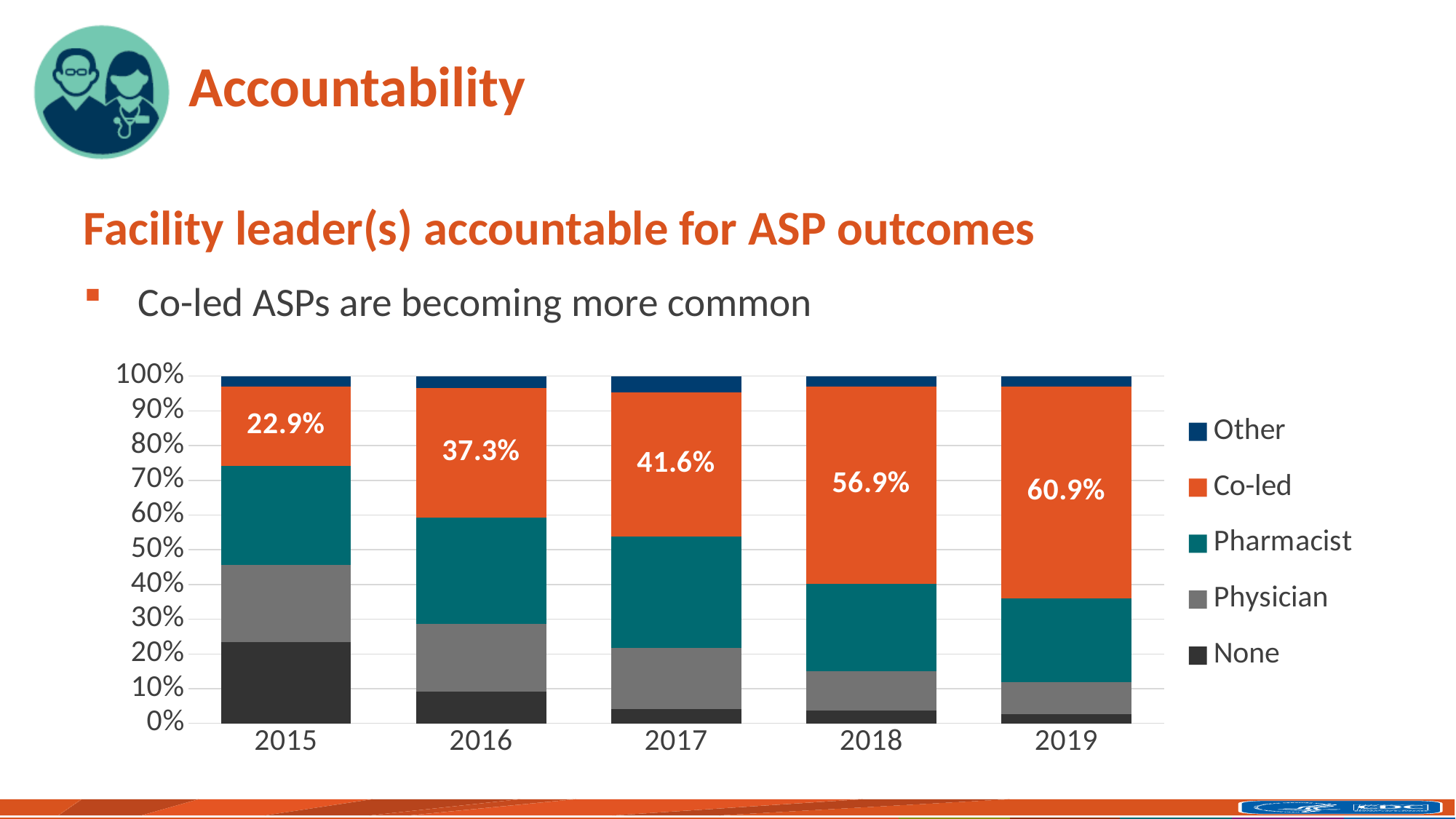
How many years are shown on the x axis? 5 How many series does the legend list? 5 Which year has a larger Co-led share, 2016 or 2018? 2018 In which year is the Co-led share lowest? 2015 What kind of chart is shown on the slide? Stacked bar chart What is the Co-led percentage for 2015? 22.9% In which year is the Co-led share highest? 2019 What is the Co-led percentage for 2017? 41.6% Is the value for None in 2015 greater or less than 20%? greater By how many percentage points did the Co-led share increase from 2015 to 2019? 38.0 percentage points Is the value for None in 2019 greater or less than 10%? less What is the Co-led percentage for 2019? 60.9%